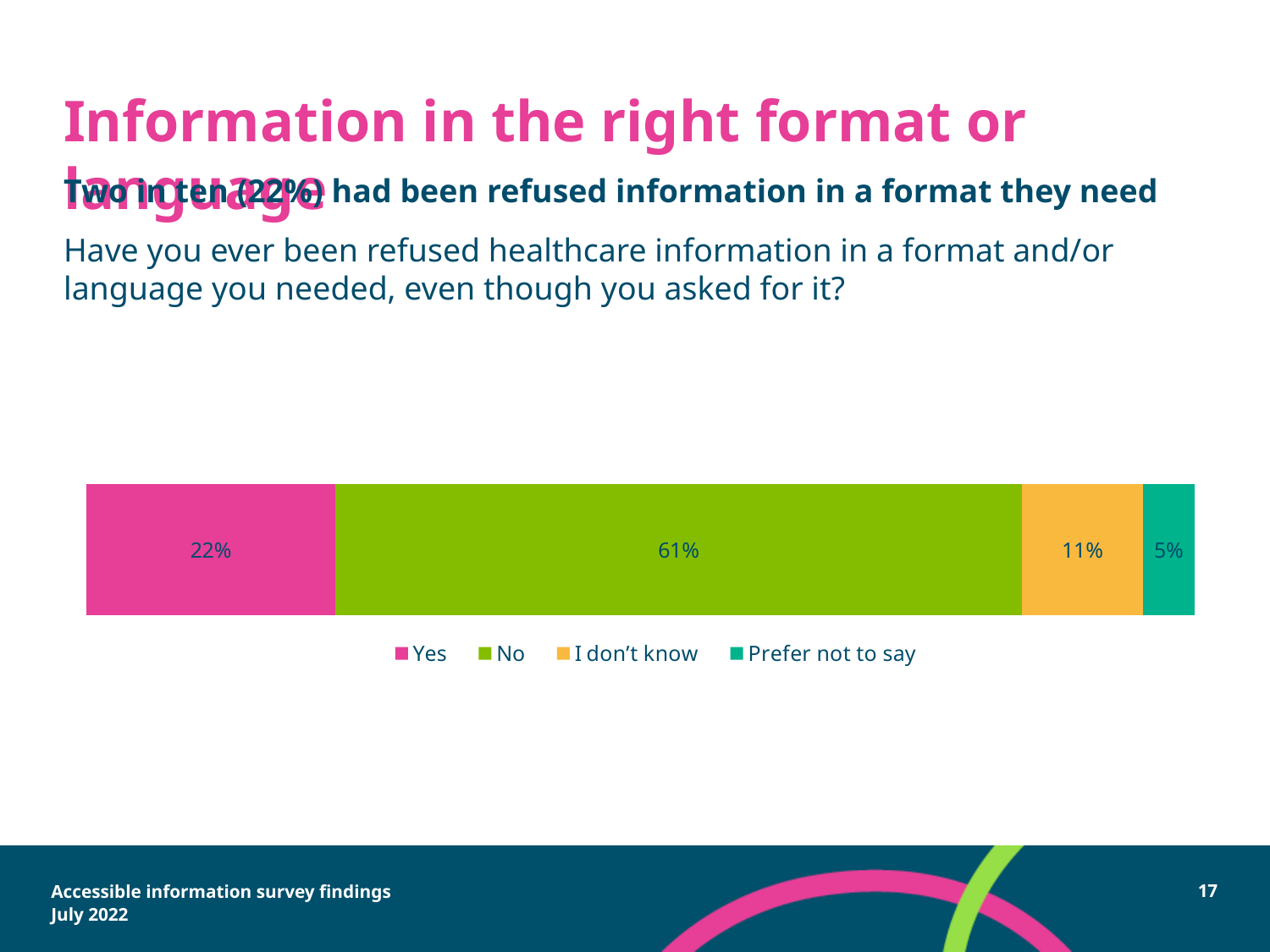
Which response has the largest share? No What percentage of respondents answered "Yes"? 22% What percentage of respondents answered "Prefer not to say"? 5% What colour is the "No" segment of the bar? Green What is the difference in percentage points between "No" and "Yes"? 39 What percentage of respondents answered "I don't know"? 11% How many response categories does the legend list? 4 Which response has the smallest share? Prefer not to say Which is larger, the share for "Yes" or the share for "I don't know"? Yes What percentage of respondents answered "No"? 61% What kind of chart is shown on the slide? Stacked bar chart What is the total of all the segments in the stacked bar? 99%